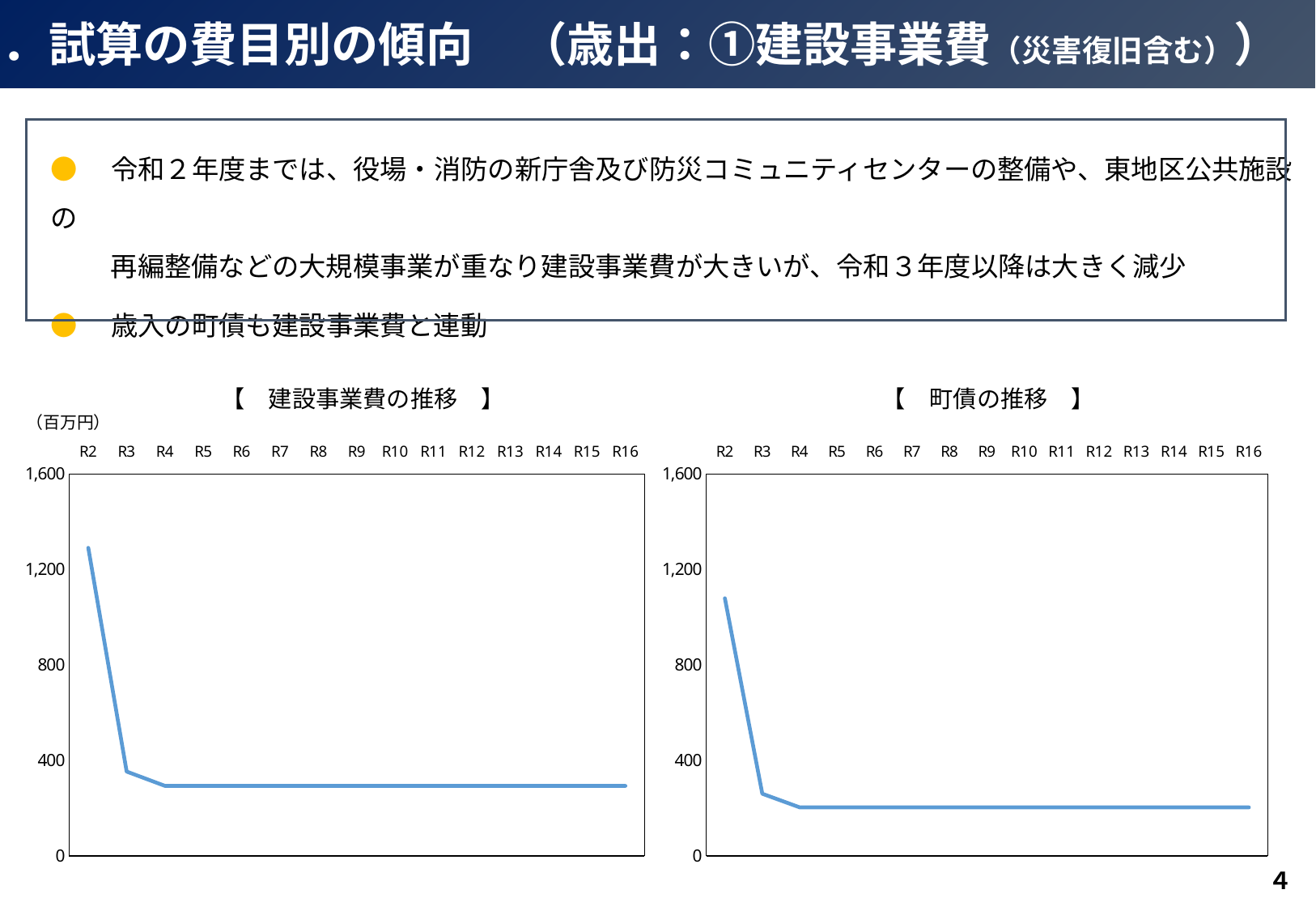
In the 町債の推移 chart, is the value for R2 greater or less than 800? greater What unit is shown above the y axis of the 建設事業費の推移 chart? 百万円 What kind of chart is the 町債の推移 chart? line chart In the 建設事業費の推移 chart, is the value for R2 greater or less than 1,200? greater In the 町債の推移 chart, is the value for R10 greater or less than 400? less In the 建設事業費の推移 chart, which year has the highest value? R2 What kind of chart is the 建設事業費の推移 chart? line chart How many fiscal years are plotted on the x axis of the 建設事業費の推移 chart? 15 In the 建設事業費の推移 chart, do the values rise or fall from R2 to R4? fall How many fiscal years are plotted on the x axis of the 町債の推移 chart? 15 In the 町債の推移 chart, which year has the highest value? R2